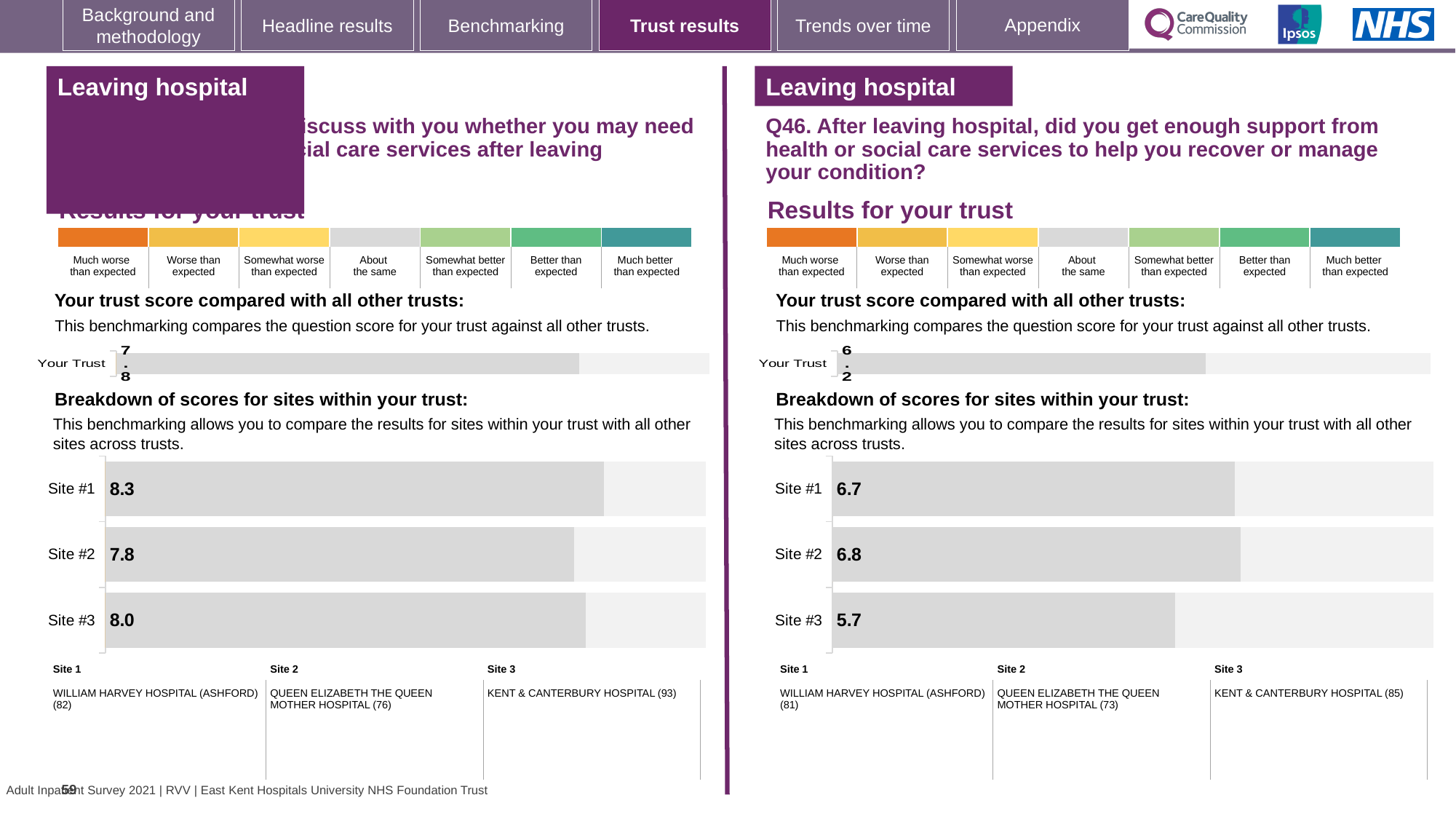
On the right-hand chart (Q46), what is the score for Site #3? 5.7 What type of chart is used for the site breakdown on the left-hand side of the slide? Bar chart On the left-hand site breakdown chart, what is the score for Site #2? 7.8 On the right-hand chart (Q46), what is the difference between the scores for Site #2 and Site #3? 1.1 On the left-hand side, what is the 'Your Trust' score shown in the trust benchmarking bar? 7.8 On the right-hand chart (Q46), which site has the lowest score? Site #3 How many sites are shown in the right-hand site breakdown chart (Q46)? 3 On the right-hand side (Q46), what is the 'Your Trust' score shown in the trust benchmarking bar? 6.2 On the left-hand site breakdown chart, which site has the highest score? Site #1 On the left-hand site breakdown chart, what is the difference between the scores for Site #1 and Site #2? 0.5 On the right-hand chart (Q46), what is the score for Site #1? 6.7 On the left-hand site breakdown chart, which is larger: the score for Site #3 or the score for Site #2? Site #3